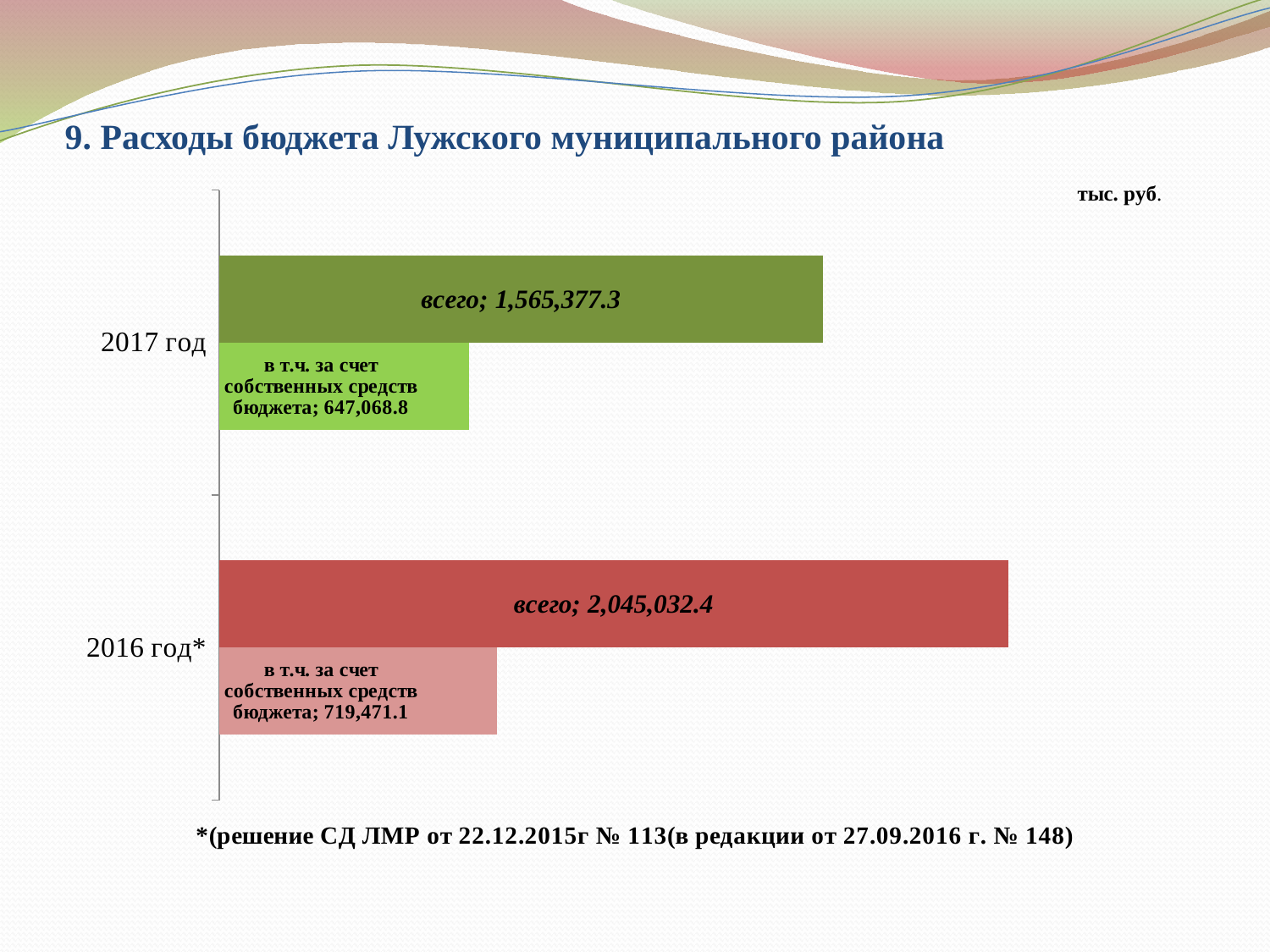
What value is shown for expenditure from own budget funds (за счет собственных средств бюджета) in 2017 год? 647,068.8 In what units are the values on the chart expressed? тыс. руб. What is the total (всего) budget expenditure shown for 2016 год*? 2,045,032.4 What is the total (всего) budget expenditure shown for 2017 год? 1,565,377.3 Which year has the lower expenditure from own budget funds? 2017 год How many years (categories) are shown on the chart? 2 By how much does the total (всего) expenditure for 2016 год* exceed that for 2017 год? 479,655.1 For 2017 год, what is the difference between the total expenditure and the expenditure from own budget funds? 918,308.5 Which year has the higher total (всего) expenditure, 2016 год* or 2017 год? 2016 год* What is the difference between the own-funds expenditure in 2016 год* and in 2017 год? 72,402.3 What value is shown for expenditure from own budget funds (за счет собственных средств бюджета) in 2016 год*? 719,471.1 What type of chart is shown on the slide? Bar chart